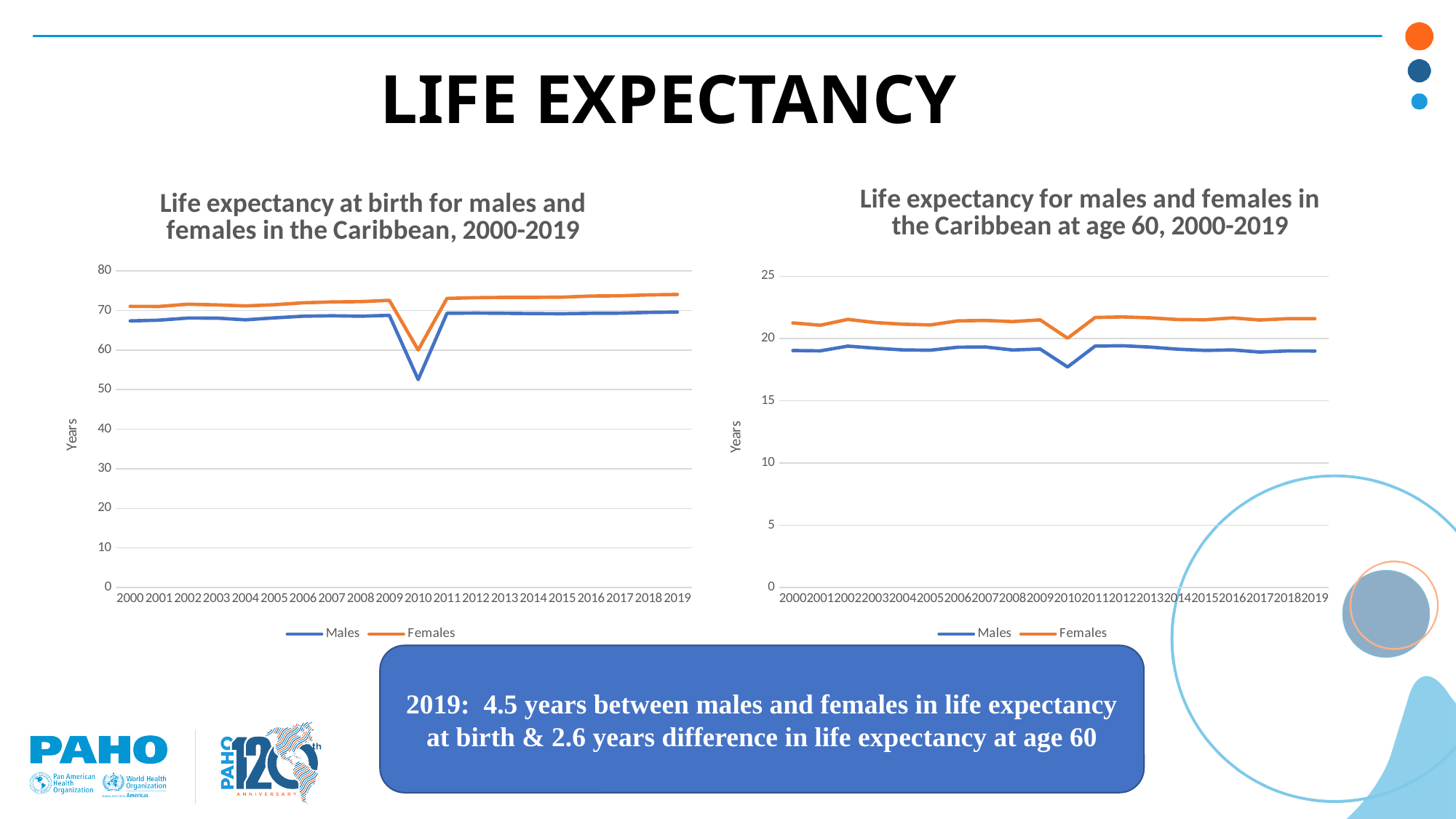
In the right chart, 'Life expectancy at age 60', which series has the higher value in 2000, Males or Females? Females How many series does the legend of the right chart, 'Life expectancy for males and females in the Caribbean at age 60, 2000-2019', list? 2 What kind of chart is the left chart, 'Life expectancy at birth for males and females in the Caribbean, 2000-2019'? Line chart In the right chart, 'Life expectancy at age 60', is the Females value for 2019 greater or less than 20? greater In the right chart, 'Life expectancy at age 60', in which year is the Males value lowest? 2010 In the left chart, 'Life expectancy at birth', is the Males value for 2010 greater or less than 60? less In the left chart, 'Life expectancy at birth', is the Females value for 2019 greater or less than 70? greater What is the y-axis label of the left chart, 'Life expectancy at birth for males and females in the Caribbean, 2000-2019'? Years In the left chart, 'Life expectancy at birth', in which year is the Males value lowest? 2010 How many years are shown on the x axis of the left chart, 'Life expectancy at birth for males and females in the Caribbean, 2000-2019'? 20 In the left chart, 'Life expectancy at birth', which series has the higher value in 2019, Males or Females? Females